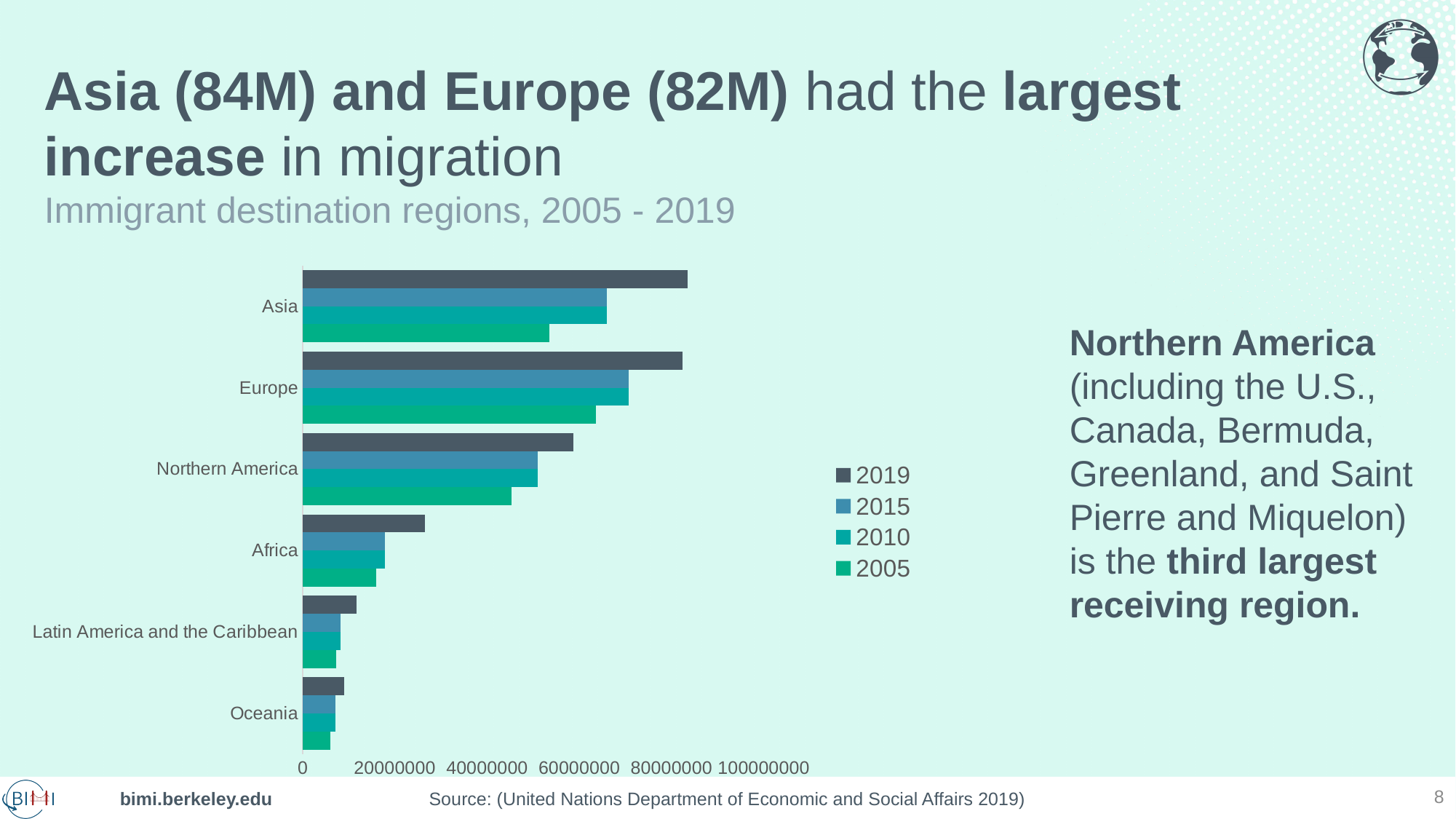
Is the 2019 value for Europe greater or less than 60000000? greater What kind of chart is shown on the slide? bar chart Is the 2019 value for Asia greater or less than 80000000? greater Is the 2019 value for Northern America greater or less than 40000000? greater Do the values for Asia rise or fall from 2005 to 2019? rise How many regions are shown on the chart's category axis? 6 Which has the larger 2019 value, Northern America or Africa? Northern America How many series does the chart's legend list? 4 What is the subtitle describing the chart? Immigrant destination regions, 2005 - 2019 Which years are listed in the chart's legend? 2019, 2015, 2010, 2005